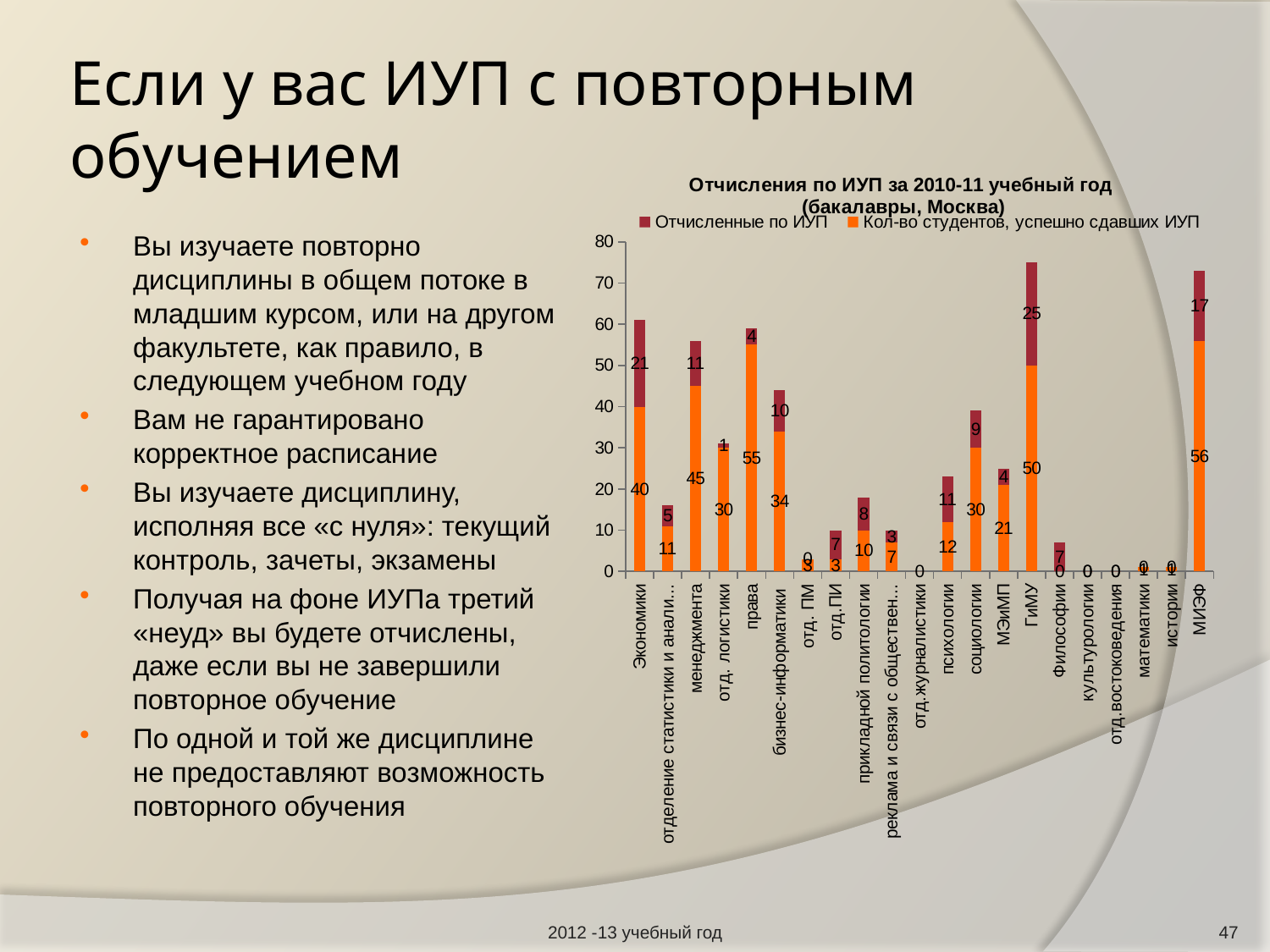
How many series does the chart legend list? 2 What kind of chart is shown on the slide? stacked bar chart Which category has the highest value of 'Отчисленные по ИУП'? ГиМУ What is the title of the chart? Отчисления по ИУП за 2010-11 учебный год (бакалавры, Москва) What is the value of 'Отчисленные по ИУП' for Экономики? 21 Which is larger: 'Отчисленные по ИУП' for психологии or for социологии? психологии What is the total height of the stacked bar for ГиМУ? 75 What is the value of 'Кол-во студентов, успешно сдавших ИУП' for МИЭФ? 56 What is the value of 'Кол-во студентов, успешно сдавших ИУП' for ГиМУ? 50 What is the total height of the stacked bar for Экономики? 61 What is the difference between 'Кол-во студентов, успешно сдавших ИУП' for права and for менеджмента? 10 Which category has the highest value of 'Кол-во студентов, успешно сдавших ИУП'? МИЭФ